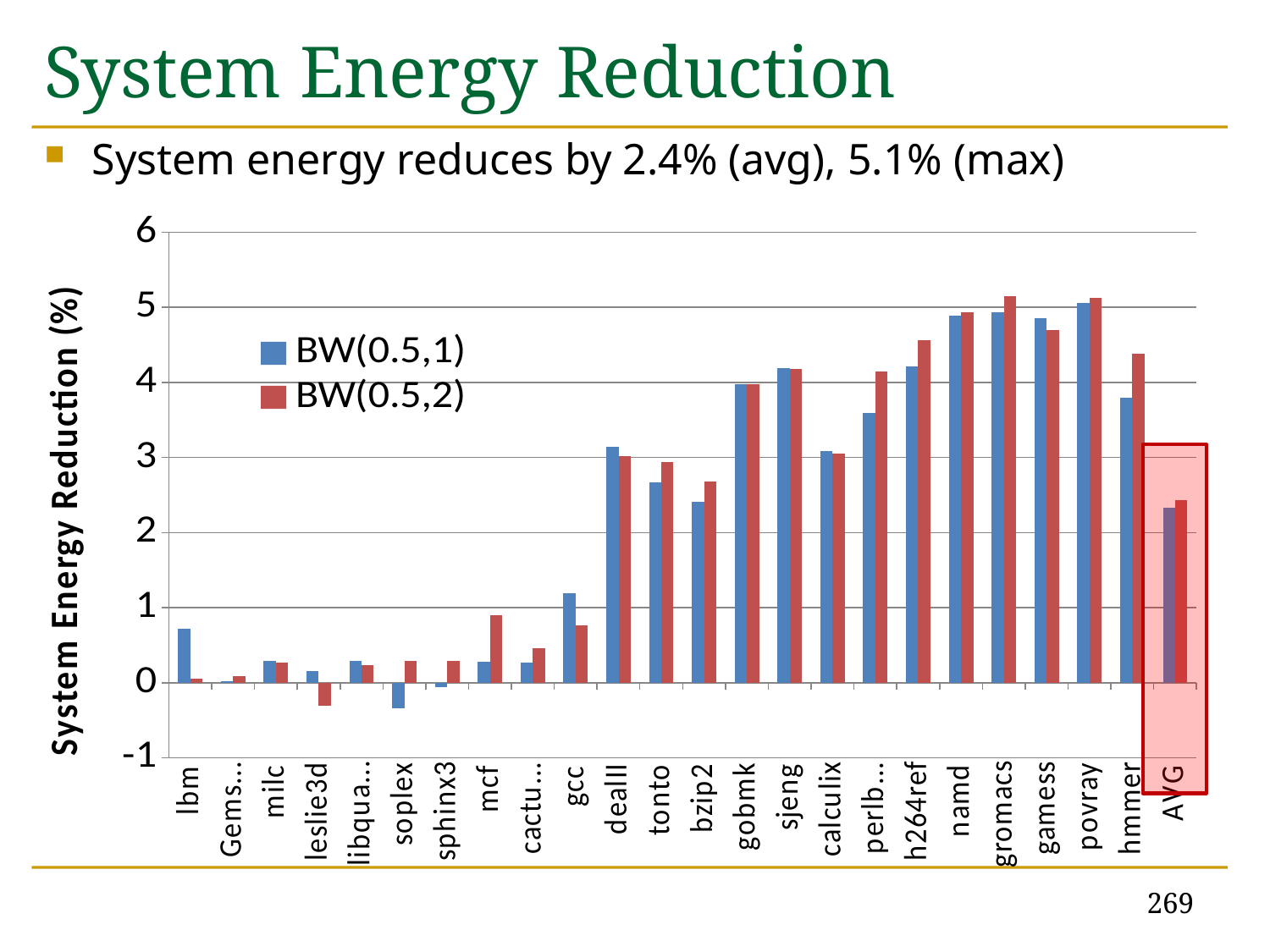
Is the BW(0.5,1) value for AVG greater or less than 2? greater Is the BW(0.5,2) value for namd greater or less than 4? greater What is the label of the y axis of the chart? System Energy Reduction (%) For gcc, which series has the larger value, BW(0.5,1) or BW(0.5,2)? BW(0.5,1) Is the BW(0.5,1) value for sjeng greater or less than 4? greater Which category has the lowest BW(0.5,1) value? soplex How many categories are plotted along the x axis of the chart? 24 For mcf, which series has the larger value, BW(0.5,1) or BW(0.5,2)? BW(0.5,2) What kind of chart is shown on the slide? bar chart How many series does the chart legend list? 2 Do the values generally rise or fall moving from left to right along the x axis? rise